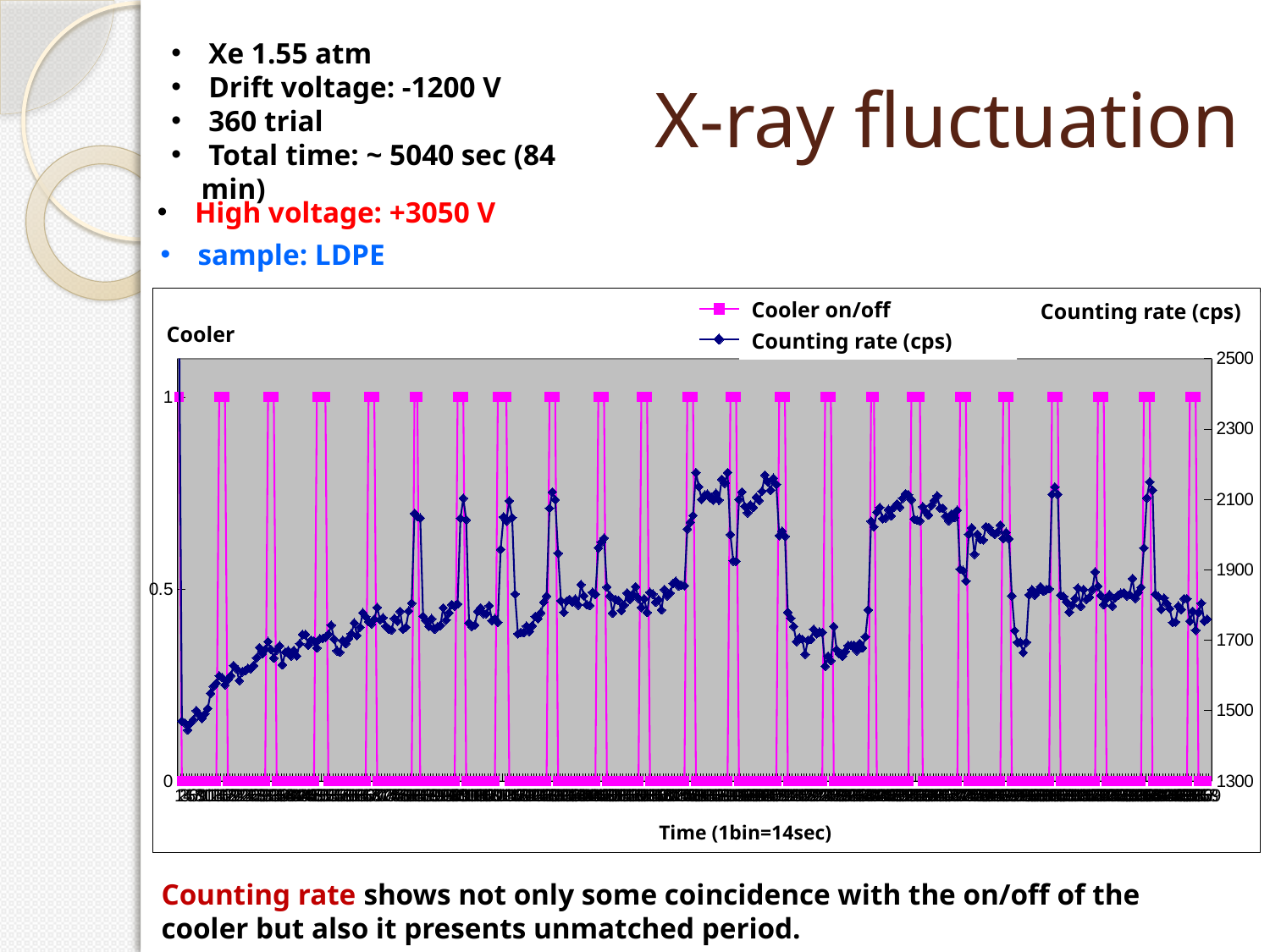
What is the title of the chart's x axis? Time (1bin=14sec) Does the counting rate rise or fall over the first part of the time axis, before the first large spike? rise Which series is drawn in magenta with square markers? Cooler on/off What is the minimum value shown on the right-hand Counting rate (cps) axis? 1300 Is the highest counting rate value plotted greater or less than 2300 cps? greater What is the maximum value shown on the left-hand Cooler axis? 1 Between which two values does the Cooler on/off series switch? 0 and 1 How many series does the chart's legend list? 2 What are the two series named in the chart's legend? Cooler on/off and Counting rate (cps) Is the lowest counting rate value plotted greater or less than 1300 cps? greater What is the maximum value shown on the right-hand Counting rate (cps) axis? 2500 What kind of chart is shown on the slide? line chart